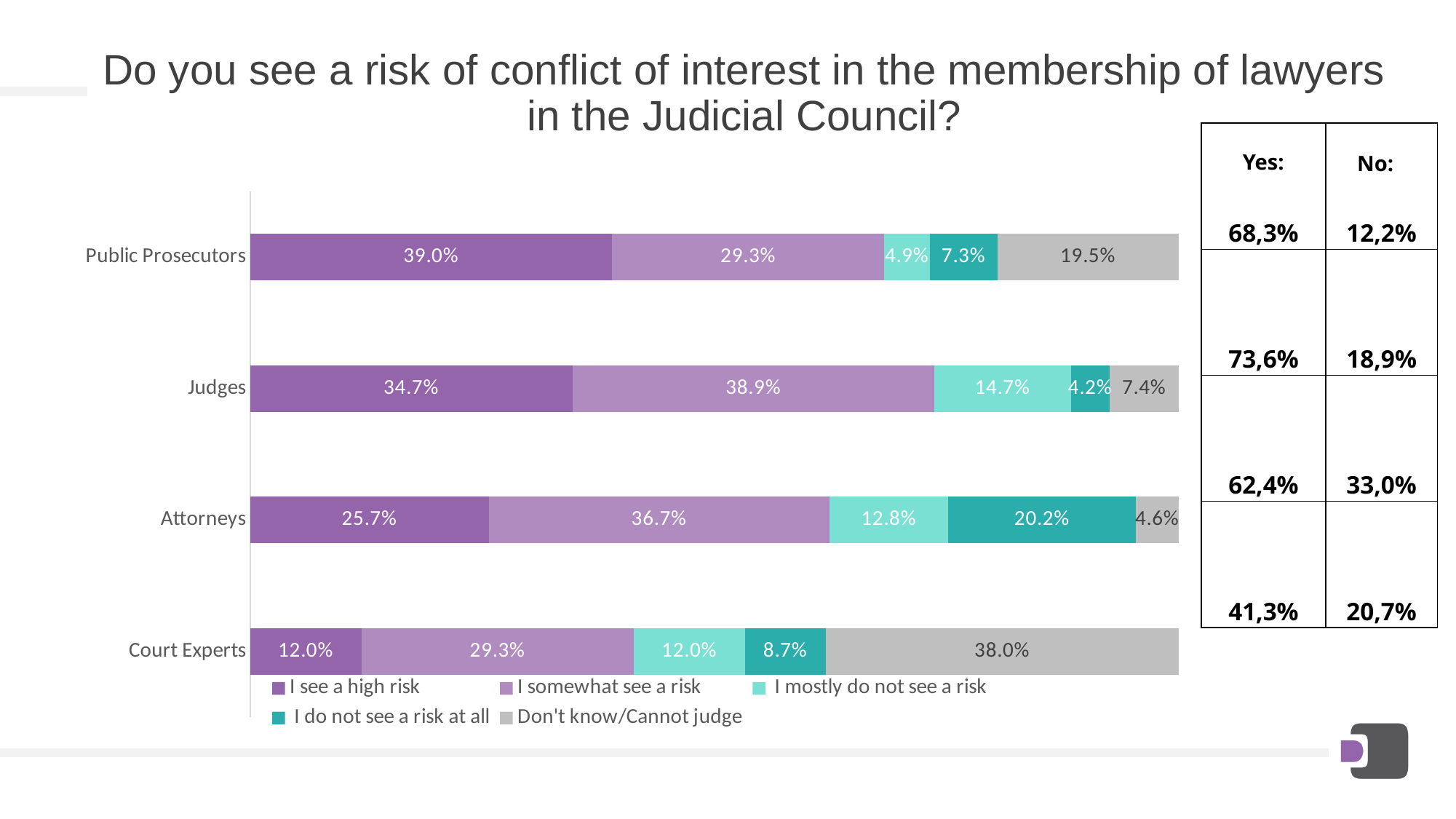
How many respondent groups are shown in the chart? 4 What type of chart is shown on the slide? Stacked bar chart What percentage of Public Prosecutors answered 'I see a high risk'? 39.0% What percentage of Court Experts answered 'Don't know/Cannot judge'? 38.0% Which group has the lowest share of 'Don't know/Cannot judge' responses? Attorneys What percentage of Judges answered 'I somewhat see a risk'? 38.9% Which is larger: the 'I mostly do not see a risk' share for Judges or for Attorneys? Judges Which group has the highest share of 'I see a high risk' responses? Public Prosecutors What percentage of Attorneys answered 'I do not see a risk at all'? 20.2% How many series does the legend list? 5 What is the combined share of 'I see a high risk' and 'I somewhat see a risk' for Attorneys? 62.4% What is the difference between the 'I see a high risk' shares of Public Prosecutors and Court Experts? 27.0%